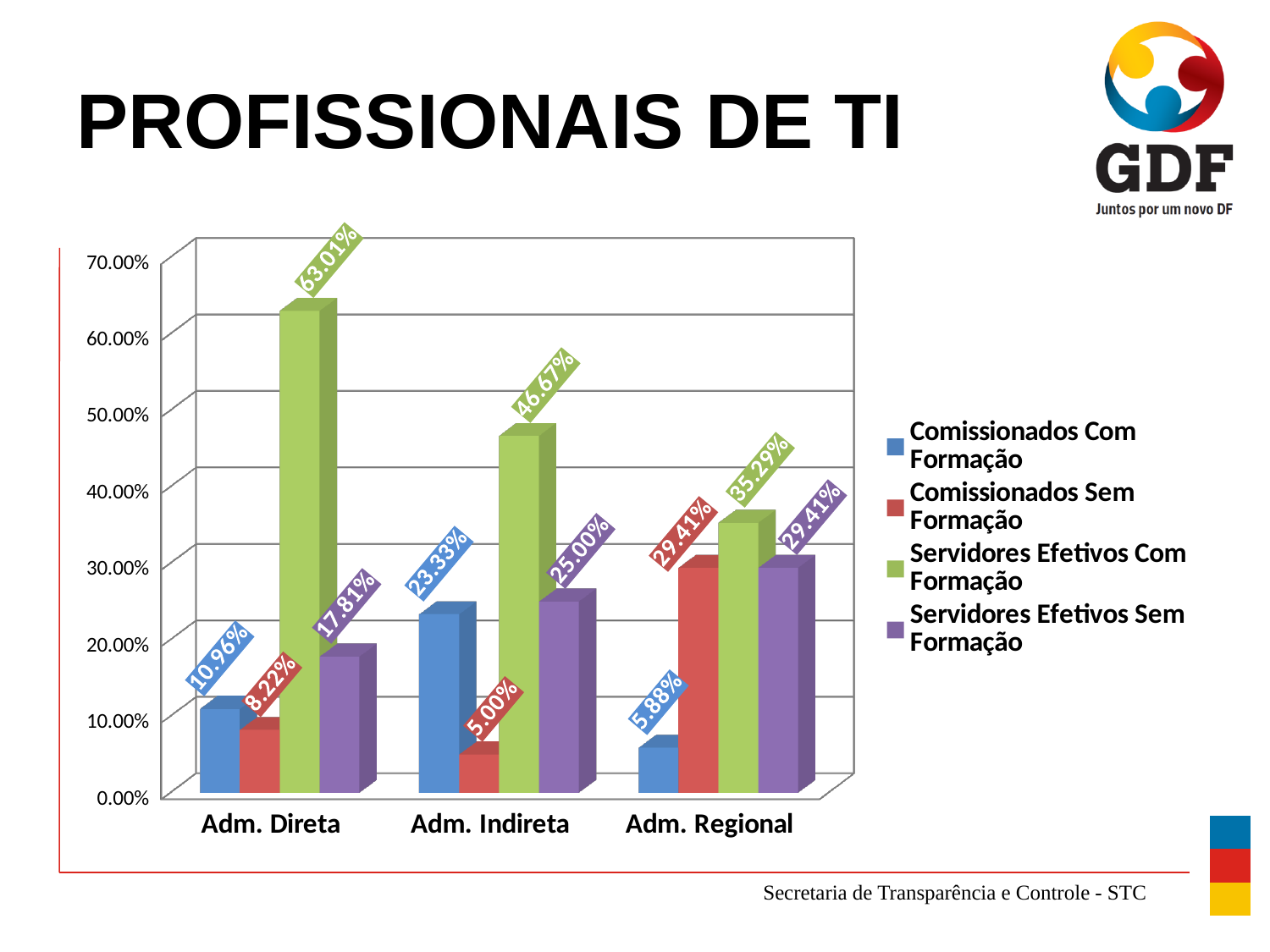
What is the difference between Servidores Efetivos Com Formação in Adm. Direta and in Adm. Indireta? 16.34% How many categories are shown on the x axis? 3 Which category has the lowest value for Comissionados Com Formação? Adm. Regional What is the value for Comissionados Sem Formação in Adm. Regional? 29.41% What kind of chart is shown on the slide? Bar chart How many series does the legend list? 4 What is the value for Servidores Efetivos Com Formação in Adm. Direta? 63.01% Is the value for Servidores Efetivos Com Formação in Adm. Regional greater or less than 30.00%? greater What is the value for Servidores Efetivos Sem Formação in Adm. Direta? 17.81% Which is larger in Adm. Indireta: Comissionados Com Formação or Servidores Efetivos Sem Formação? Servidores Efetivos Sem Formação What is the value for Comissionados Com Formação in Adm. Indireta? 23.33% Which category has the highest value for Servidores Efetivos Com Formação? Adm. Direta